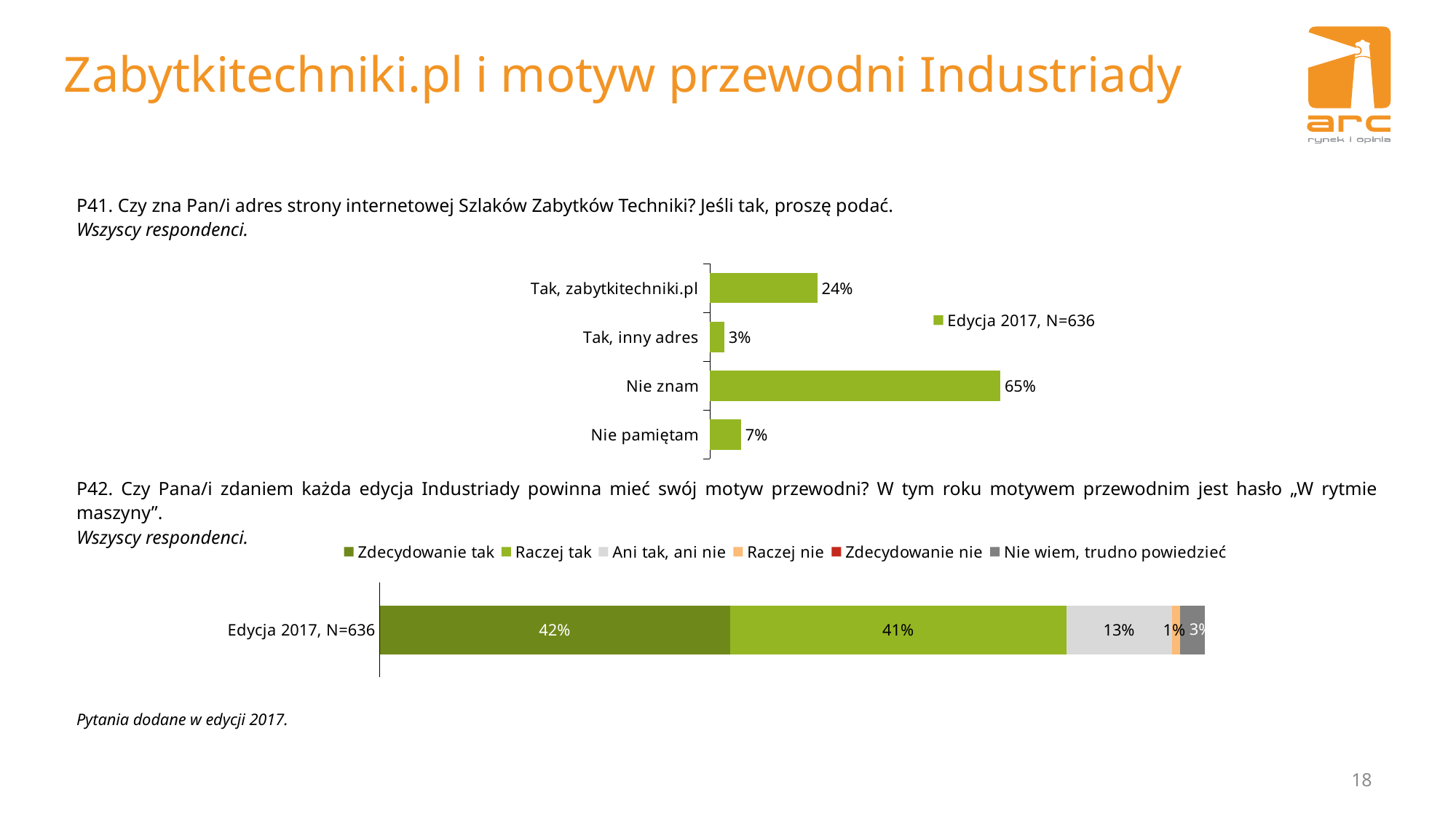
In the P41 chart (top), what percentage of respondents answered "Nie znam"? 65% In the P42 chart (bottom), what percentage answered "Zdecydowanie tak"? 42% In the P42 chart (bottom), how many series does the legend list? 6 In the P41 chart (top), what is the value for "Tak, zabytkitechniki.pl"? 24% What type of chart is the P42 chart (bottom)? Stacked bar chart In the P41 chart (top), what does the legend entry say? Edycja 2017, N=636 In the P41 chart (top), which category has the highest value? Nie znam In the P41 chart (top), what is the value for "Tak, inny adres"? 3% In the P41 chart (top), how many categories are shown? 4 In the P41 chart (top), which category has the lowest value? Tak, inny adres In the P42 chart (bottom), what percentage answered "Ani tak, ani nie"? 13% In the P41 chart (top), what is the difference between "Nie znam" and "Tak, zabytkitechniki.pl"? 41 percentage points